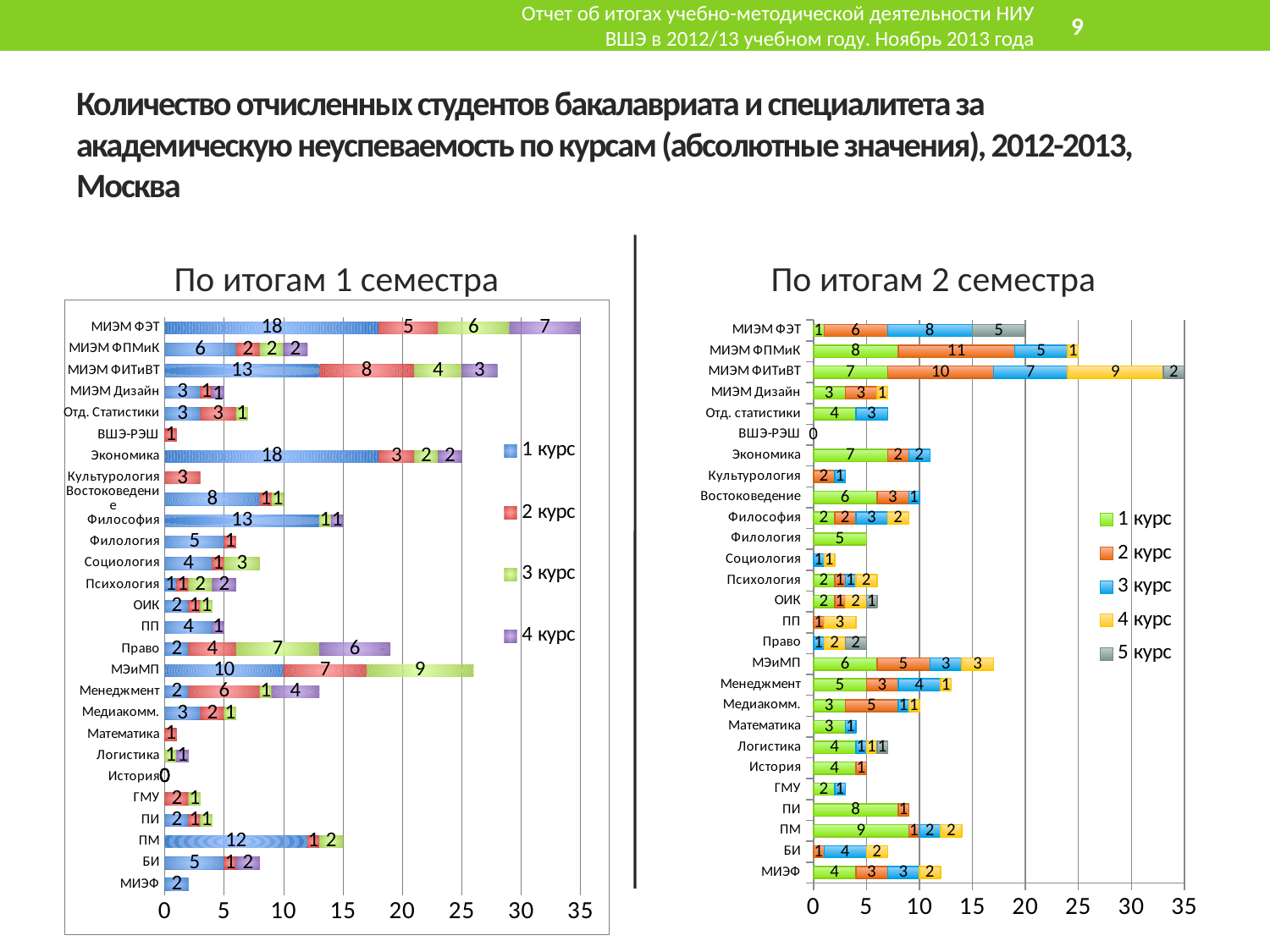
In the 'По итогам 1 семестра' chart, what is the total of the stacked bar for МИЭМ ФИТиВТ? 28 In the 'По итогам 1 семестра' chart, what is the difference between the '1 курс' values for Экономика and Философия? 5 In the 'По итогам 1 семестра' chart, what is the value of '3 курс' for Право? 7 What type of chart is used for 'По итогам 1 семестра'? Stacked bar chart In the 'По итогам 2 семестра' chart, which is larger: the '1 курс' value for ПИ or the '1 курс' value for ПМ? ПМ How many series does the legend of the 'По итогам 1 семестра' chart list? 4 In the 'По итогам 2 семестра' chart, which category has the longest total bar? МИЭМ ФИТиВТ How many series does the legend of the 'По итогам 2 семестра' chart list? 5 In the 'По итогам 2 семестра' chart, what is the value of '4 курс' for МИЭМ ФИТиВТ? 9 In the 'По итогам 2 семестра' chart, what is the total of the stacked bar for МЭиМП? 17 In the 'По итогам 1 семестра' chart, what is the value of '1 курс' for МИЭМ ФЭТ? 18 In the 'По итогам 2 семестра' chart, what is the value of '2 курс' for МИЭМ ФПМиК? 11